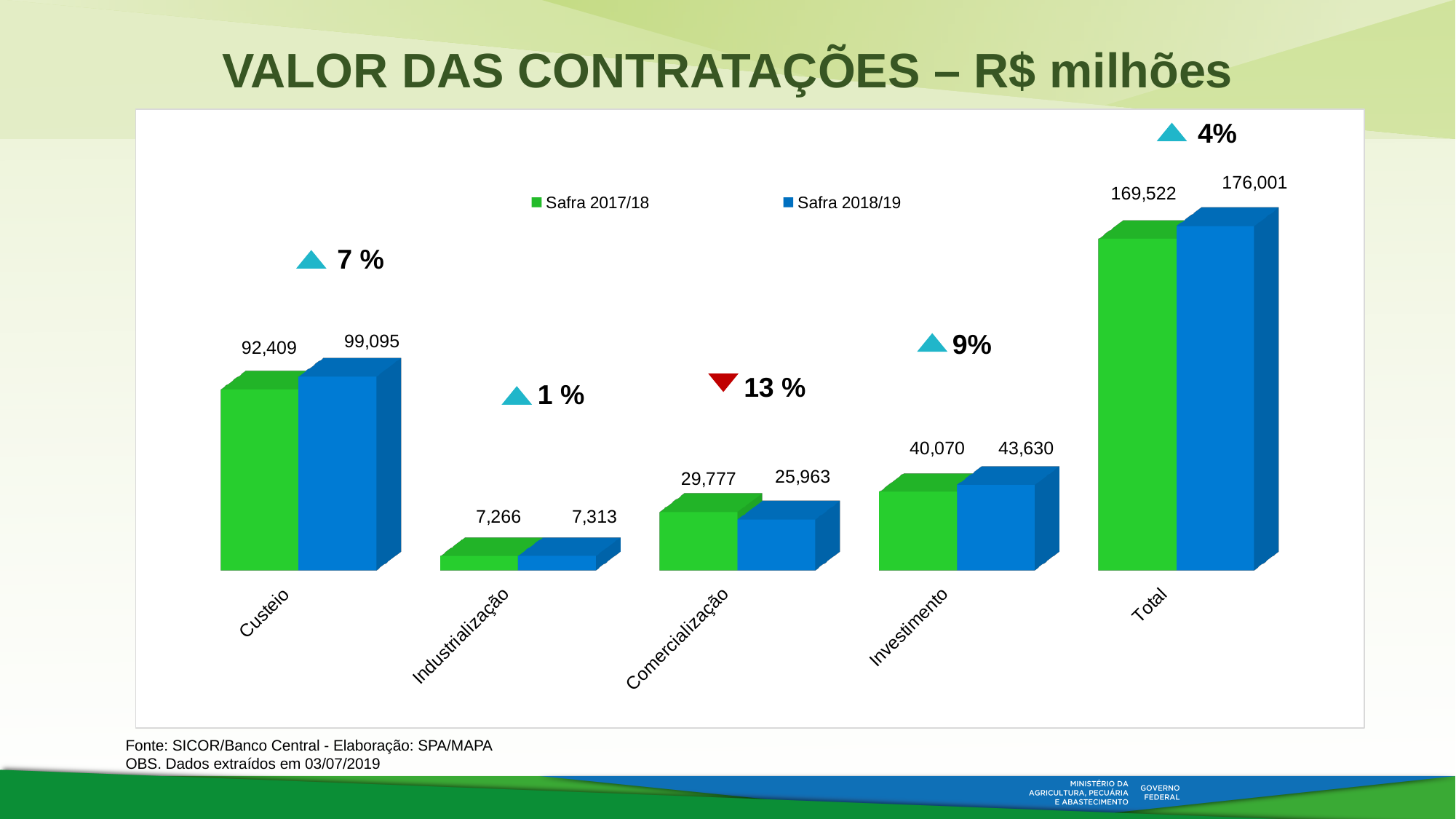
Which category has the lowest value in the Safra 2018/19 series? Industrialização Which category has the highest value in the Safra 2017/18 series? Total What is the value for Comercialização in the Safra 2017/18 series? 29,777 What is the difference between the Safra 2018/19 and Safra 2017/18 values for Custeio? 6,686 What is the difference between the Safra 2017/18 and Safra 2018/19 values for Comercialização? 3,814 How many categories are shown on the x axis? 5 What kind of chart is shown on the slide? Bar chart How many series does the legend list? 2 What is the Total value for Safra 2017/18? 169,522 What is the value for Investimento in the Safra 2018/19 series? 43,630 For Comercialização, which series has the larger value, Safra 2017/18 or Safra 2018/19? Safra 2017/18 What is the value for Custeio in the Safra 2018/19 series? 99,095